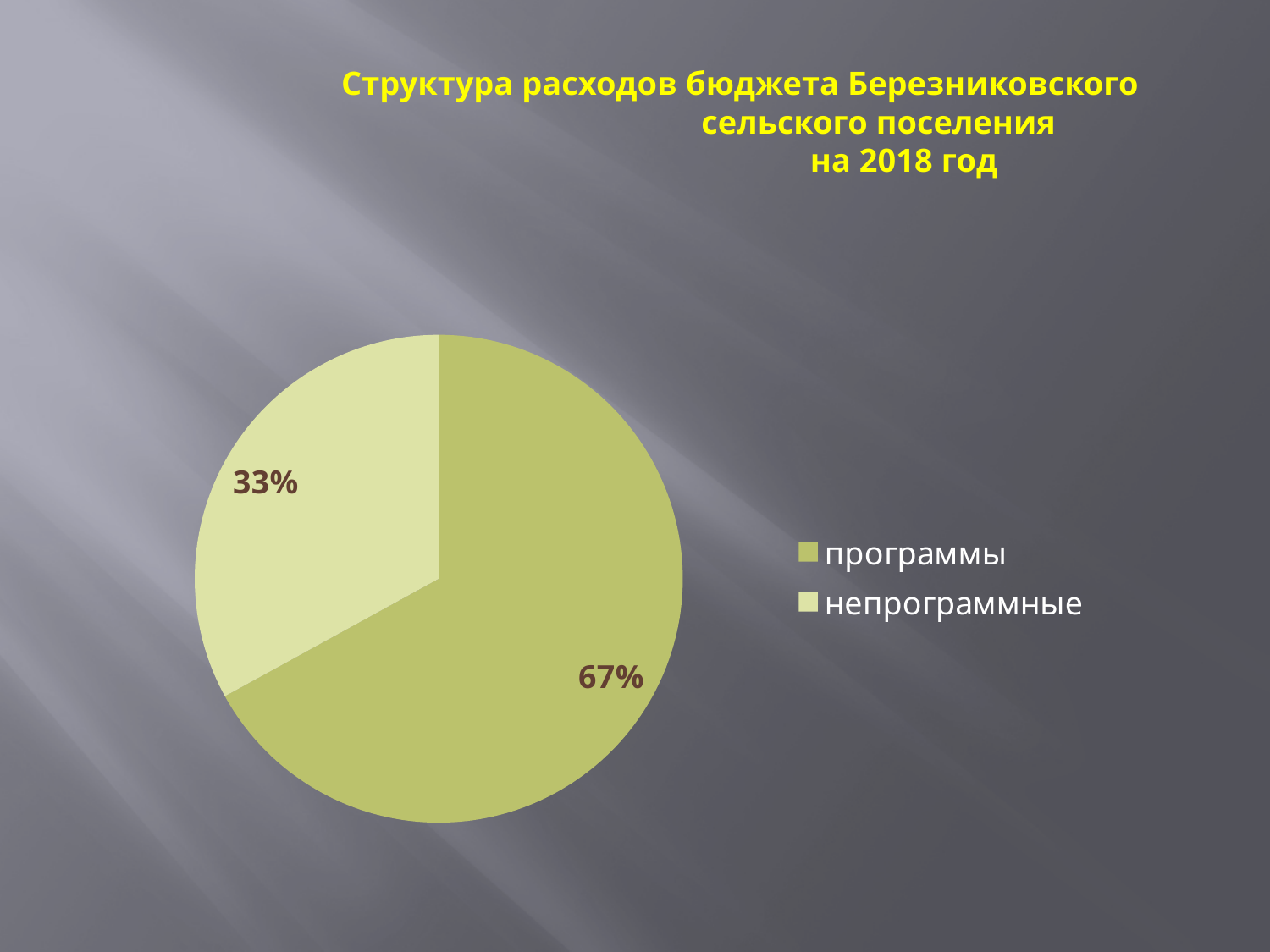
What is the title of the chart on the slide? Структура расходов бюджета Березниковского сельского поселения на 2018 год Which year does the chart title refer to? 2018 What share of the pie does the "программы" slice represent? 67% Which is larger, the "программы" slice or the "непрограммные" slice? программы How many entries does the legend list? 2 Which category has the smallest slice of the pie? непрограммные What kind of chart is shown on the slide? pie chart What share of the pie does the "непрограммные" slice represent? 33% How many slices does the pie chart have? 2 Which category has the largest slice of the pie? программы What is the difference in percentage points between the "программы" and "непрограммные" slices? 34 percentage points